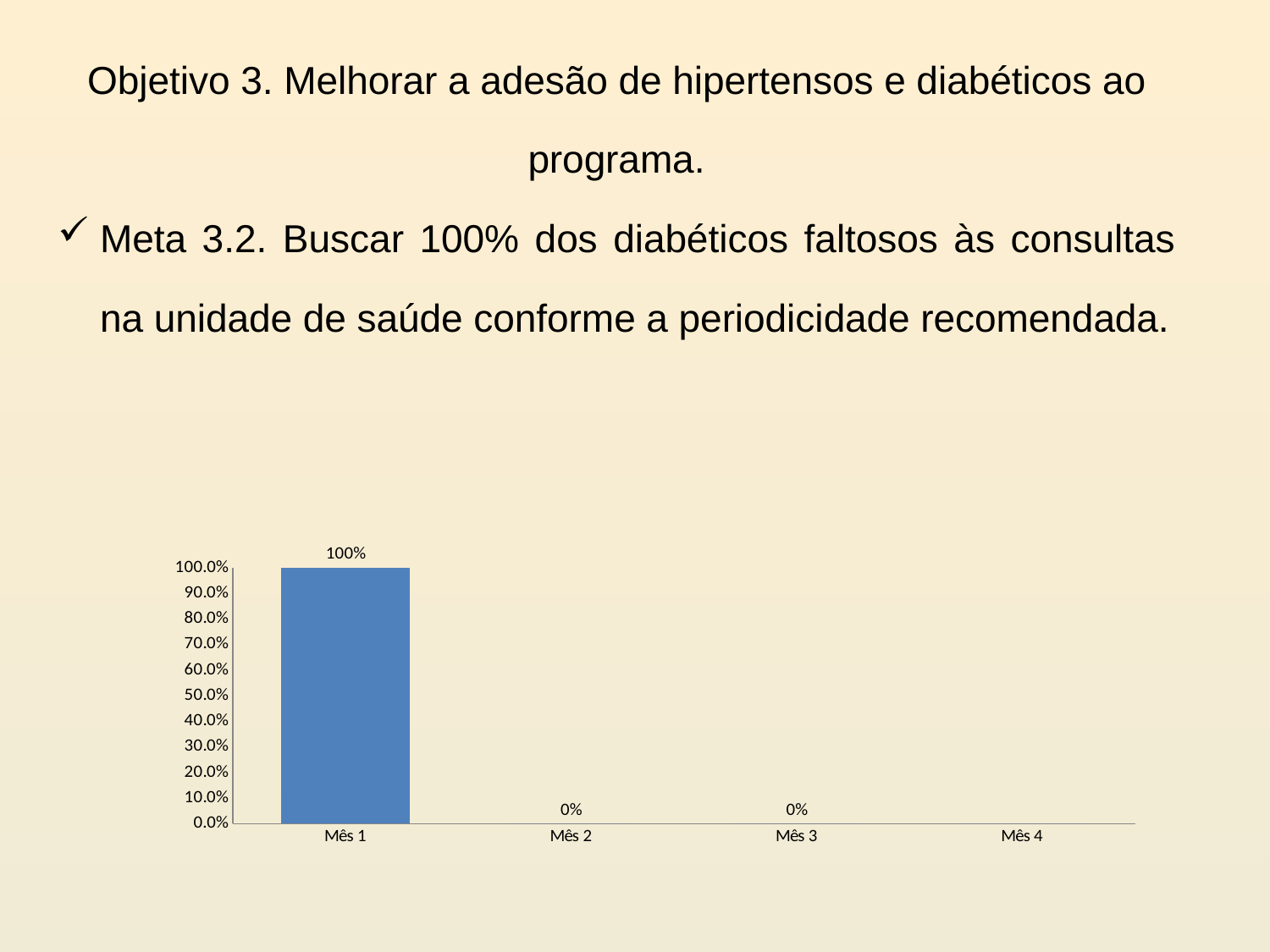
How many categories are shown on the x axis? 4 What is the value for Mês 1? 100% Which month has the highest value? Mês 1 What colour is the bar for Mês 1? blue Which is larger, the value for Mês 1 or the value for Mês 3? Mês 1 Is the value for Mês 1 greater or less than 50.0%? greater What is the highest tick label on the y axis? 100.0% What is the value for Mês 3? 0% What is the value for Mês 2? 0% What is the difference between the values for Mês 1 and Mês 2? 100% What kind of chart is shown on the slide? bar chart Do the values rise or fall from Mês 1 to Mês 2? fall